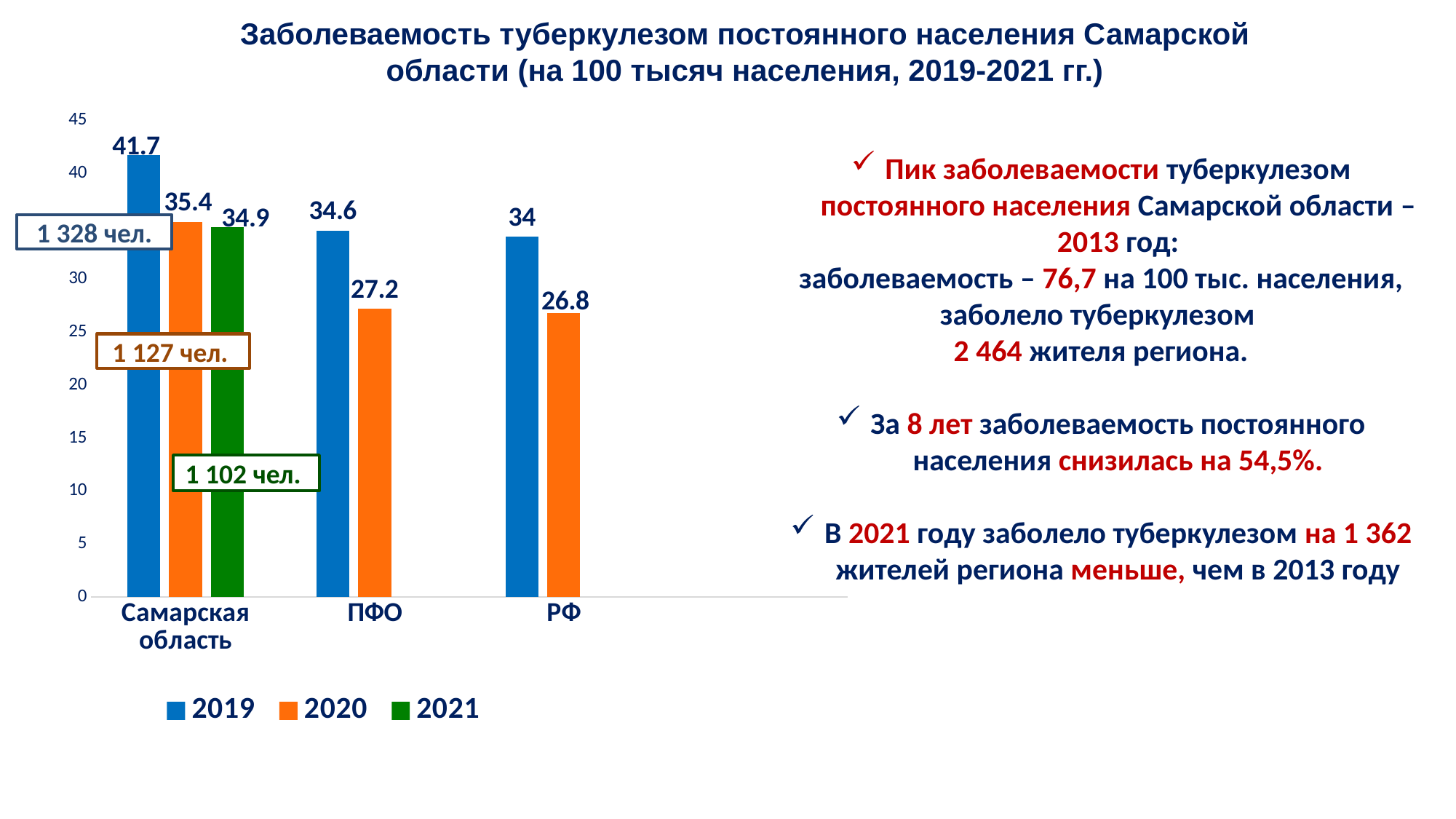
What is the difference between the 2019 and 2020 values for Самарская область? 6.3 What kind of chart is shown on the slide? bar chart Which category has the lowest 2020 value? РФ How many series does the legend list? 3 How many categories are shown on the x axis? 3 Which category has the highest 2019 value? Самарская область What is the 2021 value for Самарская область? 34.9 What is the 2019 value for Самарская область? 41.7 What is the 2020 value for РФ? 26.8 Which series is shown in green in the legend? 2021 Which is larger, the 2019 value for ПФО or the 2019 value for РФ? ПФО What is the 2020 value for ПФО? 27.2